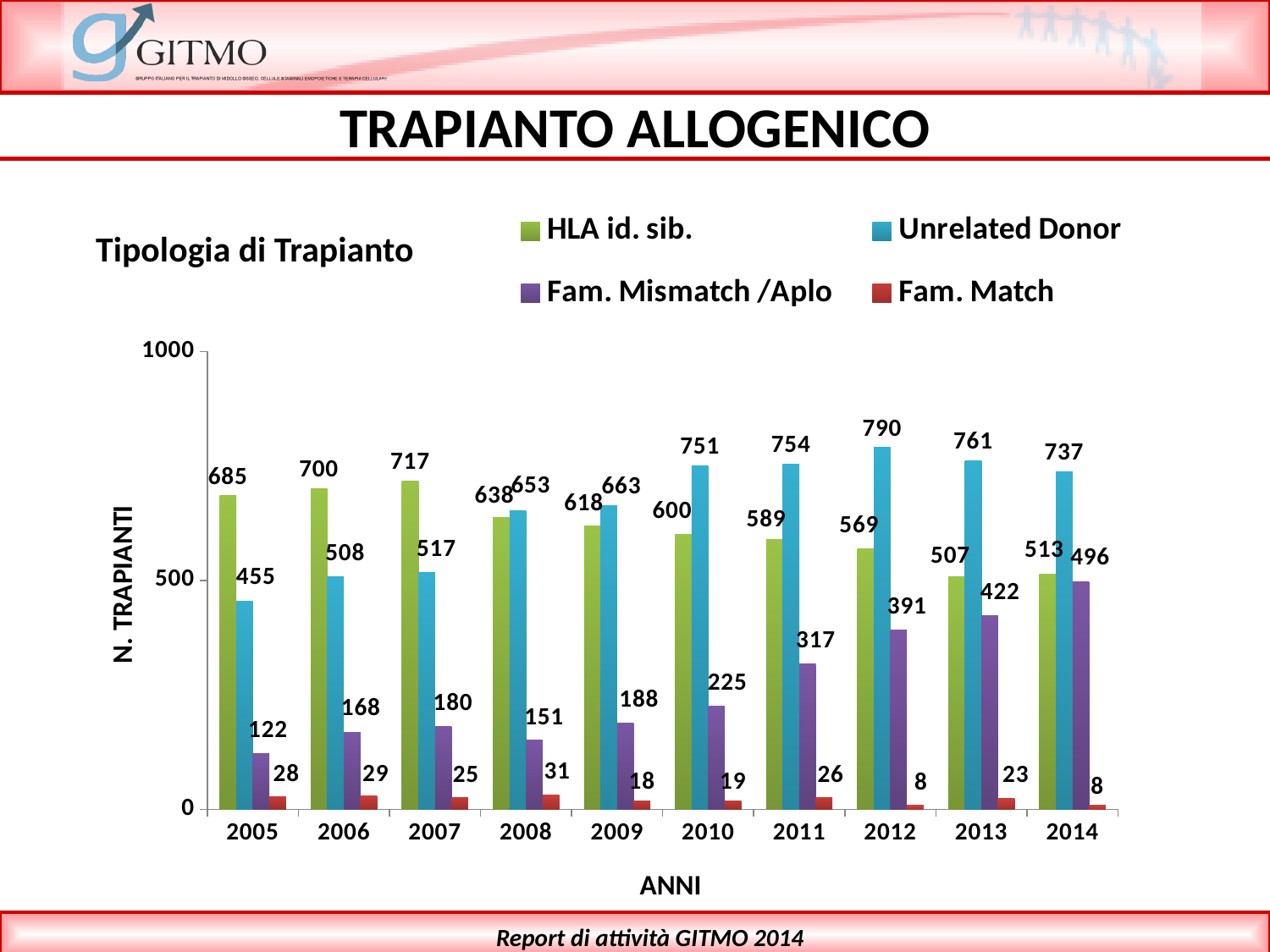
In which year is the Unrelated Donor value highest? 2012 What kind of chart is shown on the slide? Bar chart In which year is the Fam. Mismatch /Aplo value lowest? 2005 What is the difference between the Unrelated Donor and HLA id. sib. values in 2010? 151 What is the value for HLA id. sib. in 2007? 717 Which is larger in 2008, HLA id. sib. or Unrelated Donor? Unrelated Donor What is the value for Fam. Match in 2008? 31 How many series does the legend list? 4 What is the value for Fam. Mismatch /Aplo in 2014? 496 What is the value for Unrelated Donor in 2012? 790 Does the Fam. Mismatch /Aplo series rise or fall from 2005 to 2014? Rise How many years are shown on the x axis? 10